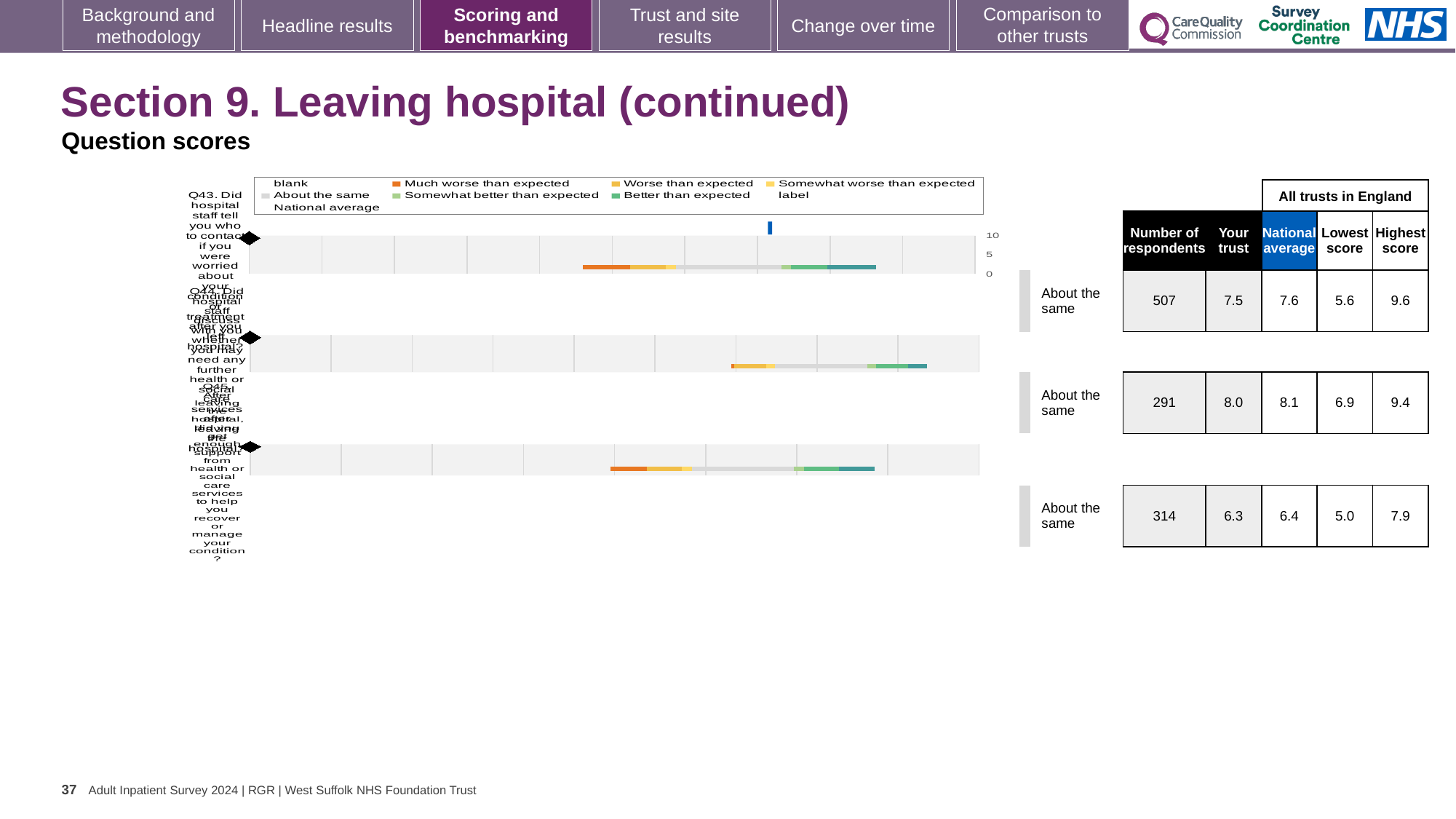
What kind of chart is used on this slide to show the question scores? bar chart For the bottom chart, what is the highest score among all trusts in England? 7.9 Which legend entry is shown in dark orange? Much worse than expected For the bottom chart, what is the lowest score among all trusts in England? 5.0 For the top chart (Q43), what is the 'Your trust' score in the table? 7.5 What is the highest value shown on the axis of the top chart? 10 How many separate question charts are shown on the slide? 3 For the top chart (Q43), what is the number of respondents? 507 For the middle chart, which is larger: the 'Your trust' score or the national average? national average Which of the three charts has the highest 'Your trust' score? the middle chart (8.0) For the middle chart, what is the national average score? 8.1 For the top chart (Q43), what is the difference between the highest score and the lowest score? 4.0